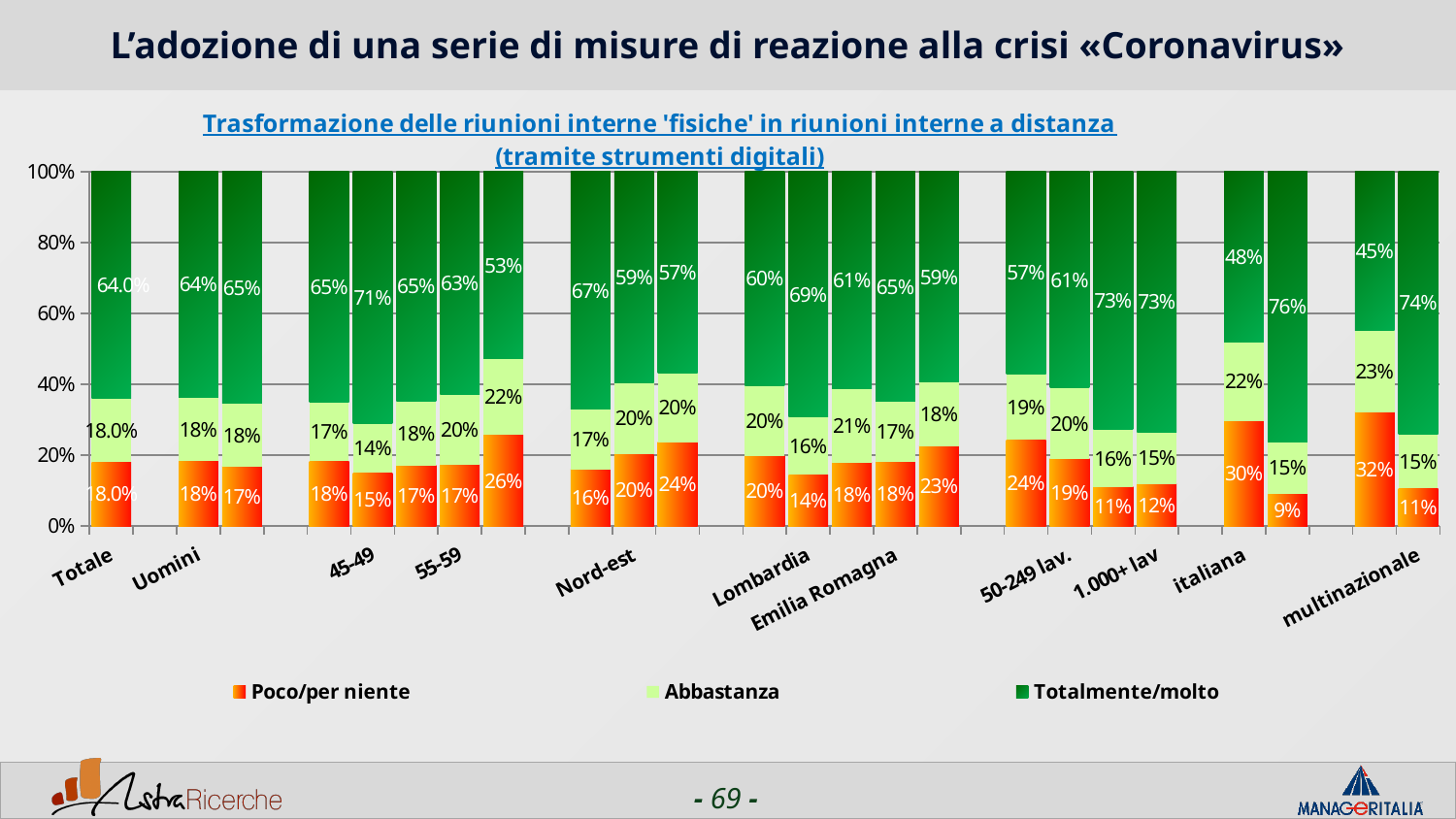
What is the 'Totalmente/molto' value for Totale? 64.0% Among the labelled categories, which has the lowest 'Totalmente/molto' value? italiana Which has the larger 'Poco/per niente' value, italiana or multinazionale? italiana What is the 'Totalmente/molto' value for Uomini? 64% What is the difference between the 'Poco/per niente' values for italiana and multinazionale? 19 percentage points What is the 'Poco/per niente' value for italiana? 30% What is the 'Totalmente/molto' value for multinazionale? 74% What is the 'Poco/per niente' value for Totale? 18.0% What type of chart is shown on the slide? Stacked bar chart How many series does the legend list? 3 Which legend entry is shown in dark green? Totalmente/molto What is the 'Totalmente/molto' value for 45-49? 71%